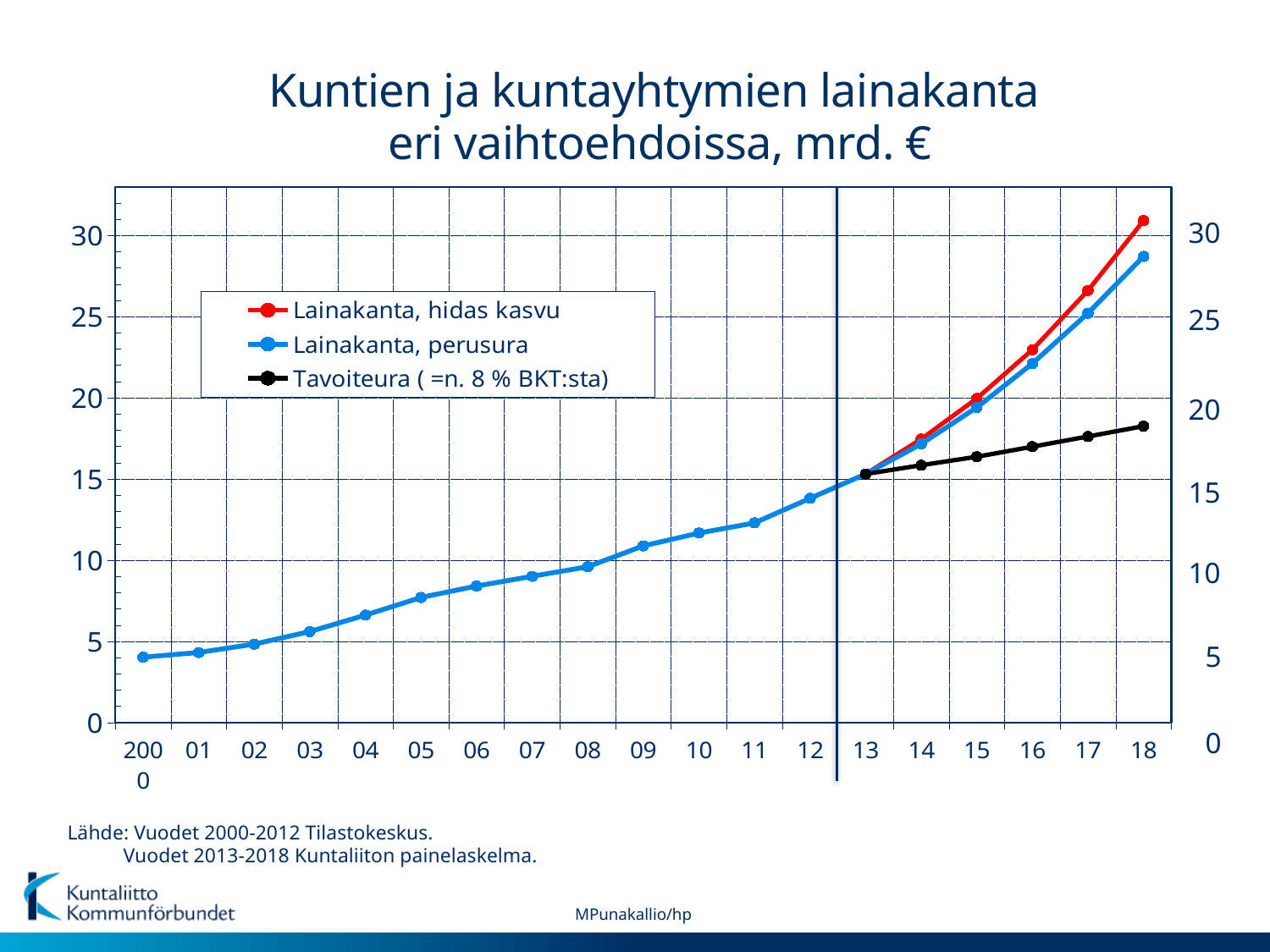
Which series has the lowest value in 2018? Tavoiteura ( =n. 8 % BKT:sta) Is the value for Lainakanta, hidas kasvu in 2018 greater or less than 25? greater What is the title of the chart? Kuntien ja kuntayhtymien lainakanta eri vaihtoehdoissa, mrd. € In 2018, which is larger: Lainakanta, hidas kasvu or Lainakanta, perusura? Lainakanta, hidas kasvu How many series does the legend list? 3 Which series has the highest value in 2018? Lainakanta, hidas kasvu How many years are shown on the x axis? 19 Is the value for Lainakanta, perusura in 2000 greater or less than 5? less Is the value for Lainakanta, perusura in 2018 greater or less than 30? less Does the Lainakanta, perusura series rise or fall from 2000 to 2018? rise What kind of chart is shown on the slide? line chart